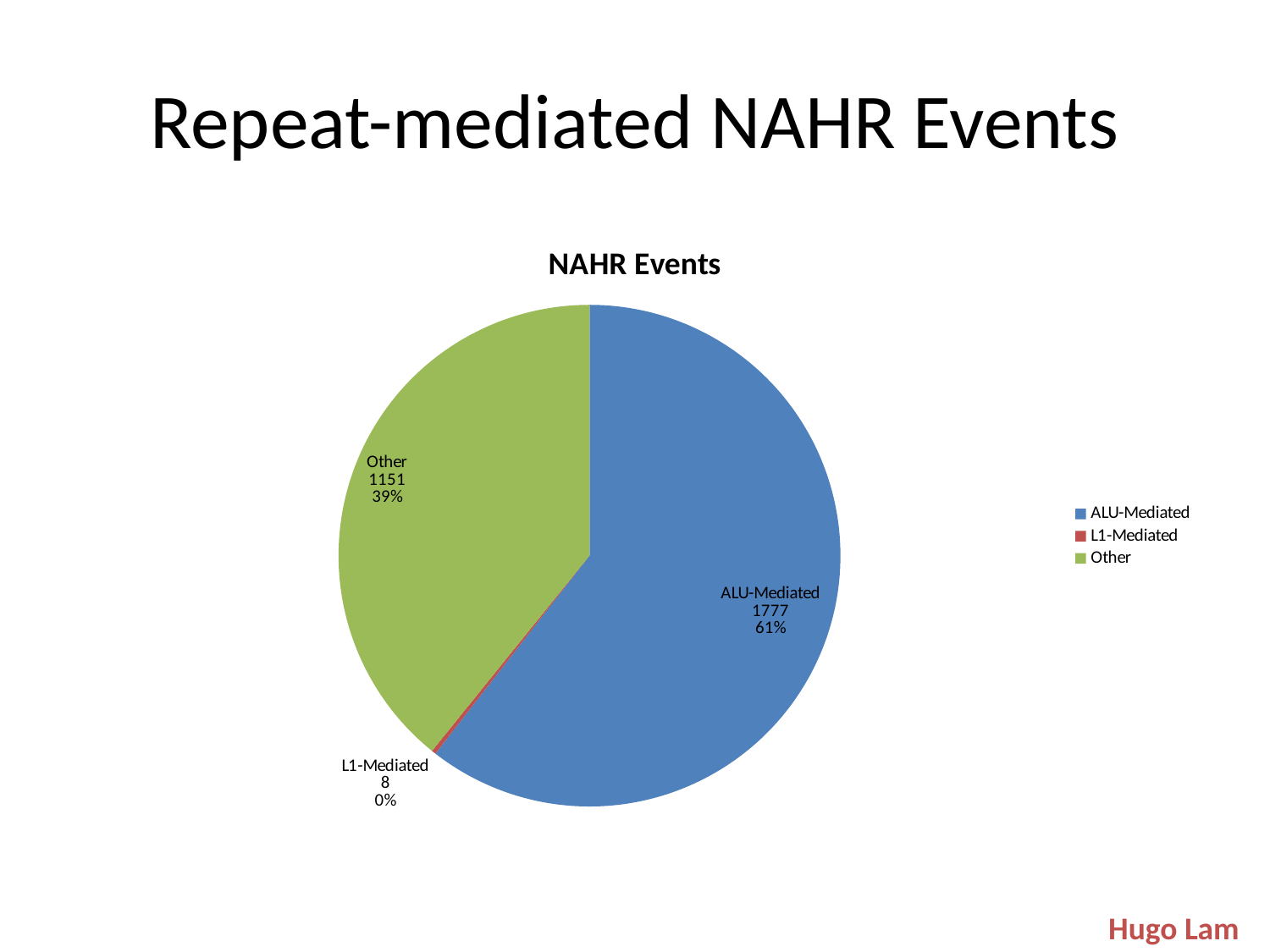
Which category has the smallest slice? L1-Mediated How many entries does the legend list? 3 What share of the pie does Other represent? 39% What is the value for L1-Mediated? 8 What is the title of the chart? NAHR Events What share of the pie does ALU-Mediated represent? 61% What is the value for Other? 1151 What is the difference between the ALU-Mediated and Other values? 626 What kind of chart is shown on the slide? pie chart What is the value for ALU-Mediated? 1777 How many slices does the pie chart have? 3 Which category has the largest slice? ALU-Mediated